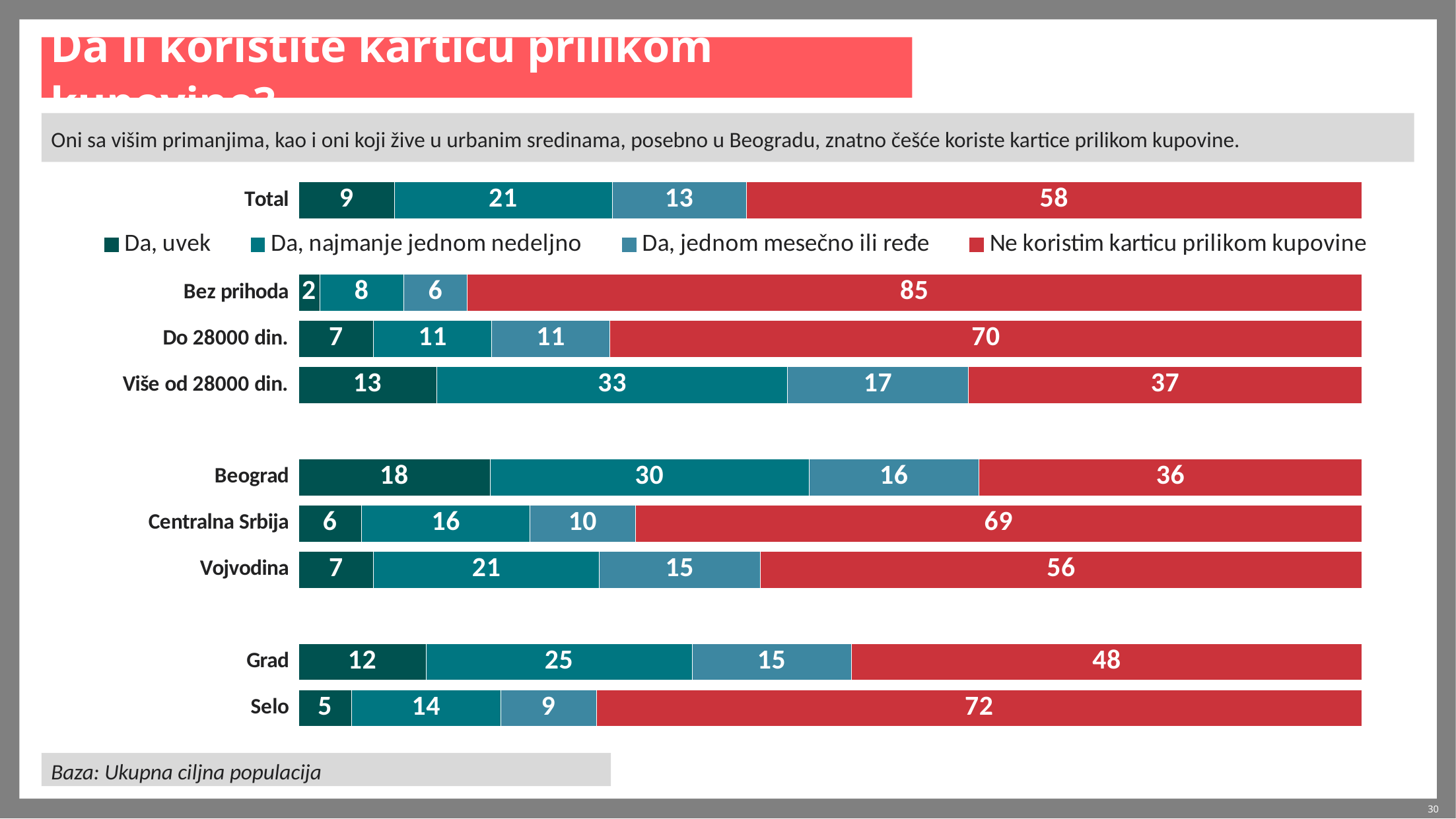
Which series is shown in red in the legend? Ne koristim karticu prilikom kupovine What is the difference between the "Ne koristim karticu prilikom kupovine" values for Selo and Grad? 24 Which category has the highest value for "Ne koristim karticu prilikom kupovine"? Bez prihoda How many categories (bars) are plotted in the chart? 9 What is the value of "Ne koristim karticu prilikom kupovine" for Bez prihoda? 85 Which is larger: the "Da, jednom mesečno ili ređe" value for Vojvodina or for Centralna Srbija? Vojvodina What is the total of the stacked bar for Beograd? 100 What is the value of "Da, uvek" for Beograd? 18 Which category has the lowest value for "Da, uvek"? Bez prihoda What is the value of "Da, najmanje jednom nedeljno" for Više od 28000 din.? 33 How many series does the legend list? 4 What kind of chart is shown on the slide? Stacked bar chart